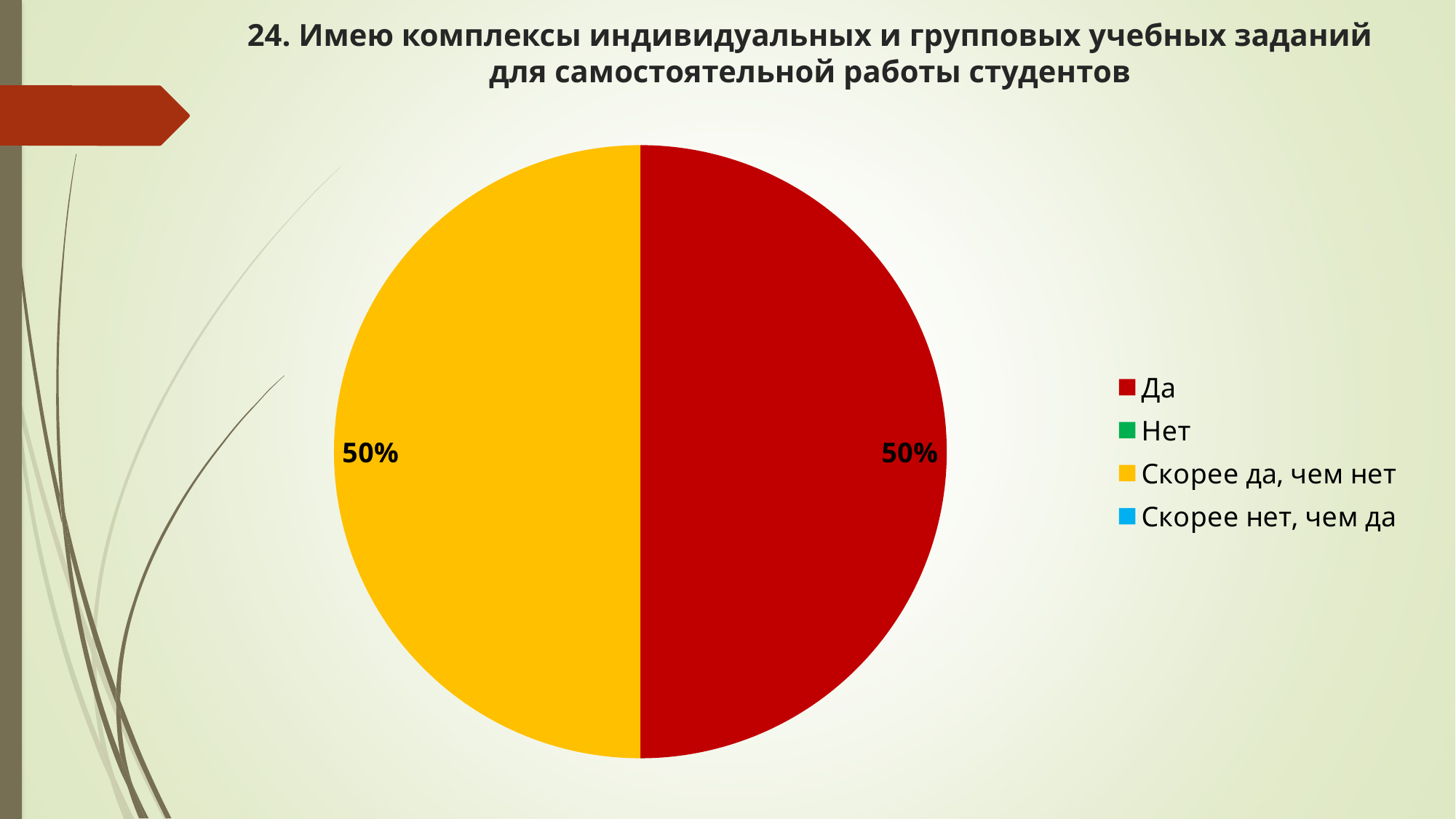
Which legend entry corresponds to the yellow slice? Скорее да, чем нет What share of the pie does the "Скорее да, чем нет" slice represent? 50% Is the share for "Да" greater or less than 25%? greater What is the value shown on the yellow slice of the pie? 50% What is the value shown on the red slice of the pie? 50% What share of the pie does the "Да" slice represent? 50% How many entries does the legend list? 4 Which legend entry corresponds to the red slice? Да How many slices with data labels are visible in the pie? 2 What type of chart is shown on the slide? pie chart Is the share for "Скорее да, чем нет" greater or less than 75%? less What is the difference between the "Да" share and the "Скорее да, чем нет" share? 0%